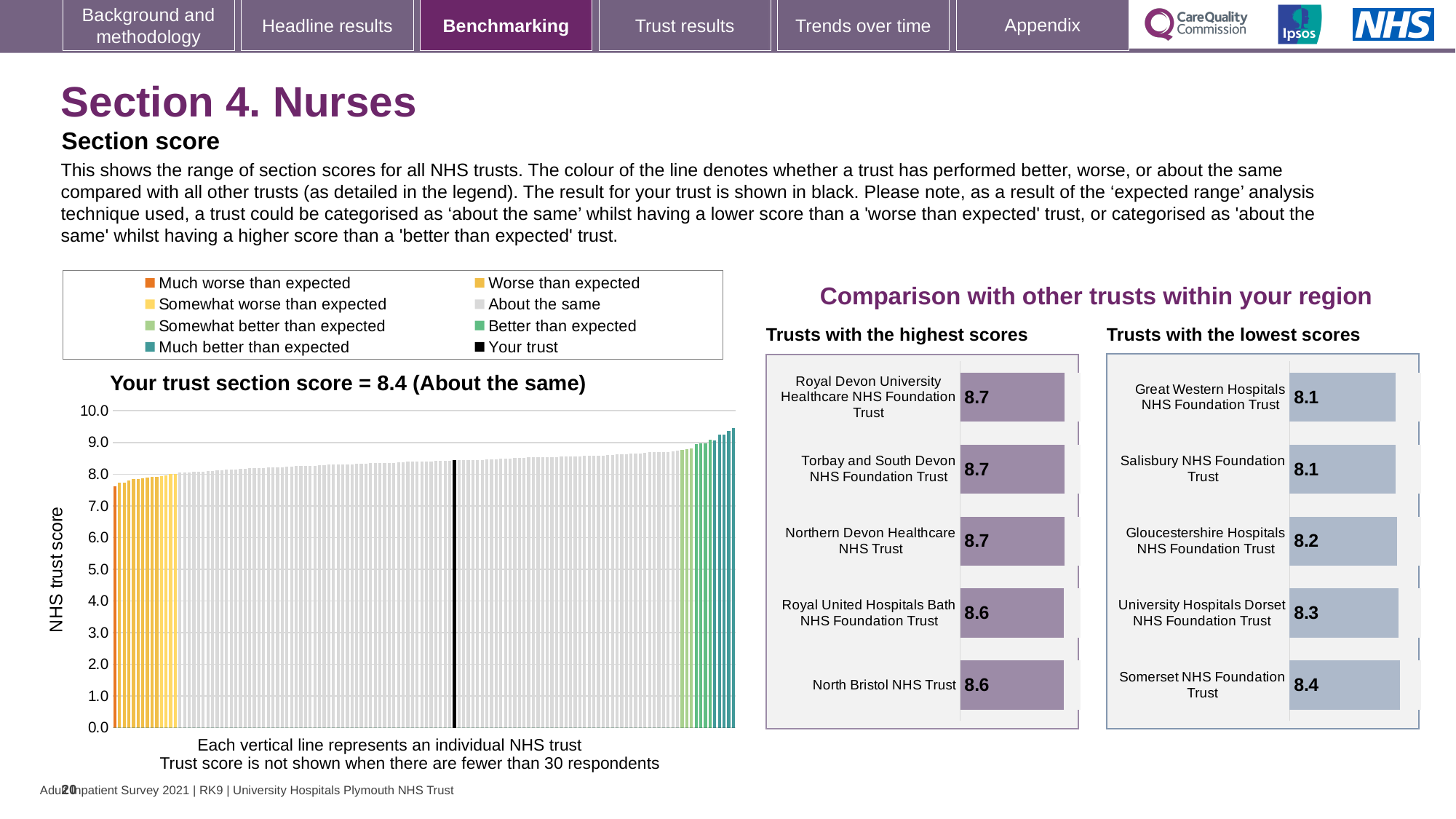
In the 'Trusts with the highest scores' chart, what is the score for North Bristol NHS Trust? 8.6 What kind of chart is the 'Your trust section score' chart? bar chart In the 'Your trust section score' chart, is the value of the lowest (leftmost) bar greater or less than 8.0? less In the 'Trusts with the lowest scores' chart, what is the difference between the scores of Somerset NHS Foundation Trust and Great Western Hospitals NHS Foundation Trust? 0.3 In the 'Your trust section score' chart, is the value of the highest (rightmost) bar greater or less than 9.0? greater In the 'Your trust section score' chart, what is the section score for your trust? 8.4 In the 'Trusts with the highest scores' chart, how many trusts are shown? 5 In the 'Trusts with the lowest scores' chart, what is the score for Gloucestershire Hospitals NHS Foundation Trust? 8.2 In the 'Trusts with the lowest scores' chart, which trust has the highest score? Somerset NHS Foundation Trust In the 'Your trust section score' chart, how many entries does the legend list? 8 In the 'Trusts with the highest scores' chart, what is the difference between the scores of Royal Devon University Healthcare NHS Foundation Trust and North Bristol NHS Trust? 0.1 In the 'Your trust section score' chart, what is the label on the vertical axis? NHS trust score